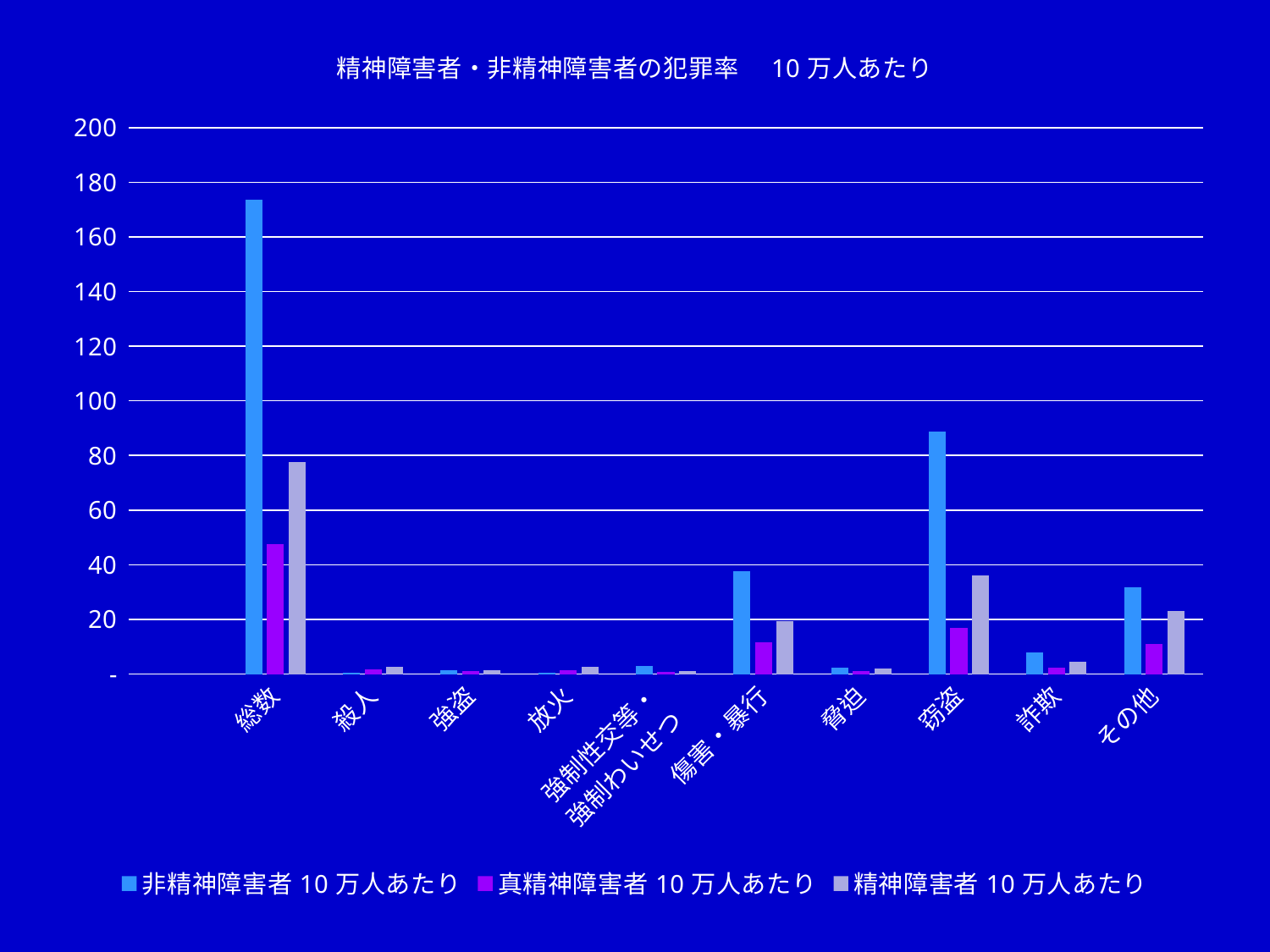
In the 非精神障害者 10万人あたり series, which is larger: 窃盗 or 傷害・暴行? 窃盗 How many categories are shown on the x axis? 10 Is the value for 窃盗 in the 非精神障害者 10万人あたり series greater or less than 80? greater Which category has the highest value for 非精神障害者 10万人あたり? 総数 What is the title of the chart? 精神障害者・非精神障害者の犯罪率 10万人あたり How many series does the legend list? 3 Excluding 総数, which category has the highest value for 精神障害者 10万人あたり? 窃盗 What kind of chart is shown on the slide? Bar chart Is the value for 総数 in the 精神障害者 10万人あたり series greater or less than 100? less Is the value for 総数 in the 真精神障害者 10万人あたり series greater or less than 40? greater For 総数, which series has the larger value: 非精神障害者 10万人あたり or 精神障害者 10万人あたり? 非精神障害者 10万人あたり